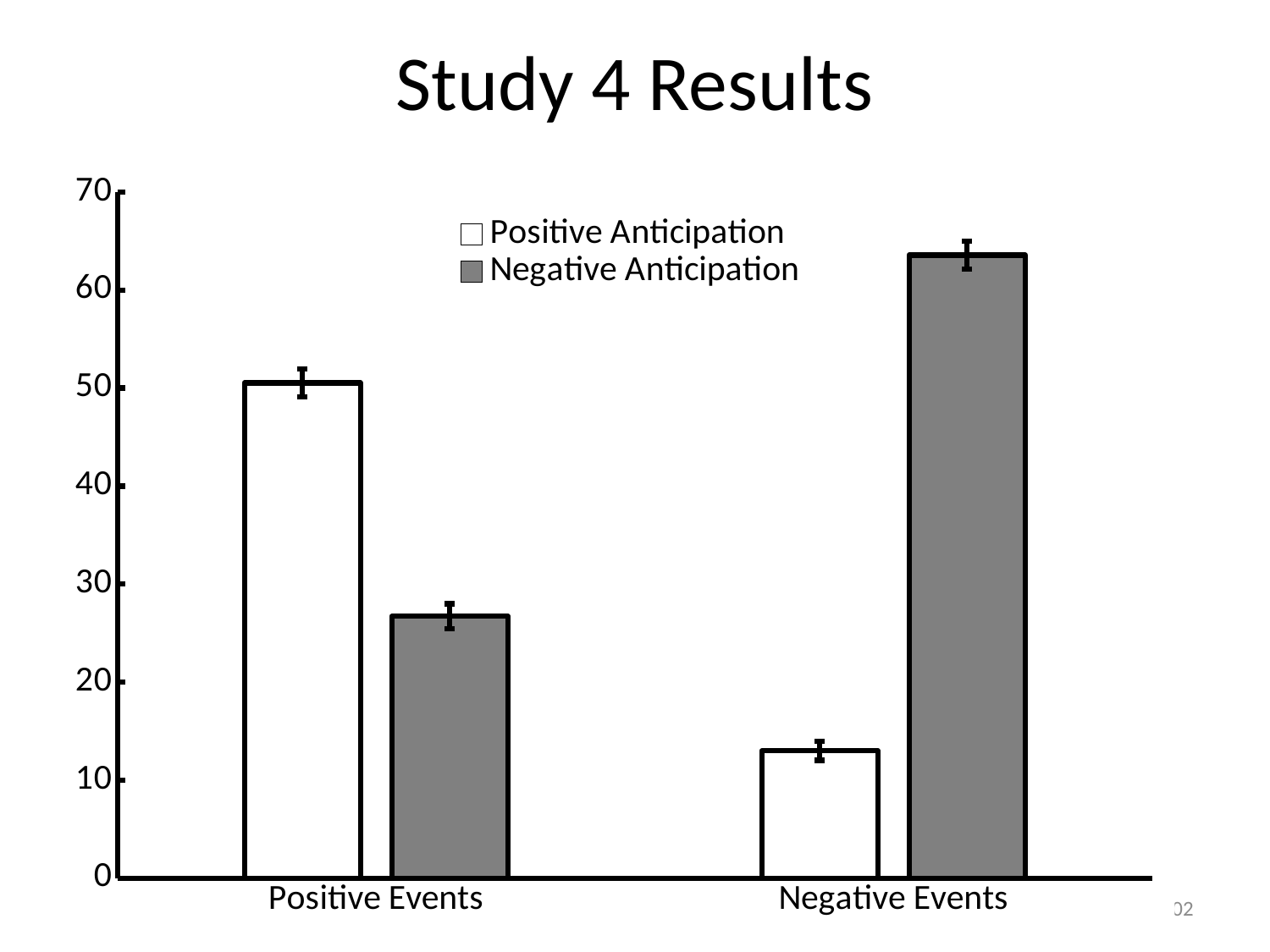
Is the value for Negative Anticipation for Negative Events greater or less than 60? greater Is the value for Positive Anticipation for Negative Events greater or less than 20? less For Negative Events, which is larger: Positive Anticipation or Negative Anticipation? Negative Anticipation For Positive Events, which is larger: Positive Anticipation or Negative Anticipation? Positive Anticipation How many event categories are shown on the x axis? 2 Which series has the tallest bar on the chart? Negative Anticipation Is the value for Negative Anticipation for Positive Events greater or less than 30? less What kind of chart is shown on the slide? bar chart Which bar is the lowest on the chart? Positive Anticipation for Negative Events What is the title of the slide? Study 4 Results How many series does the legend list? 2